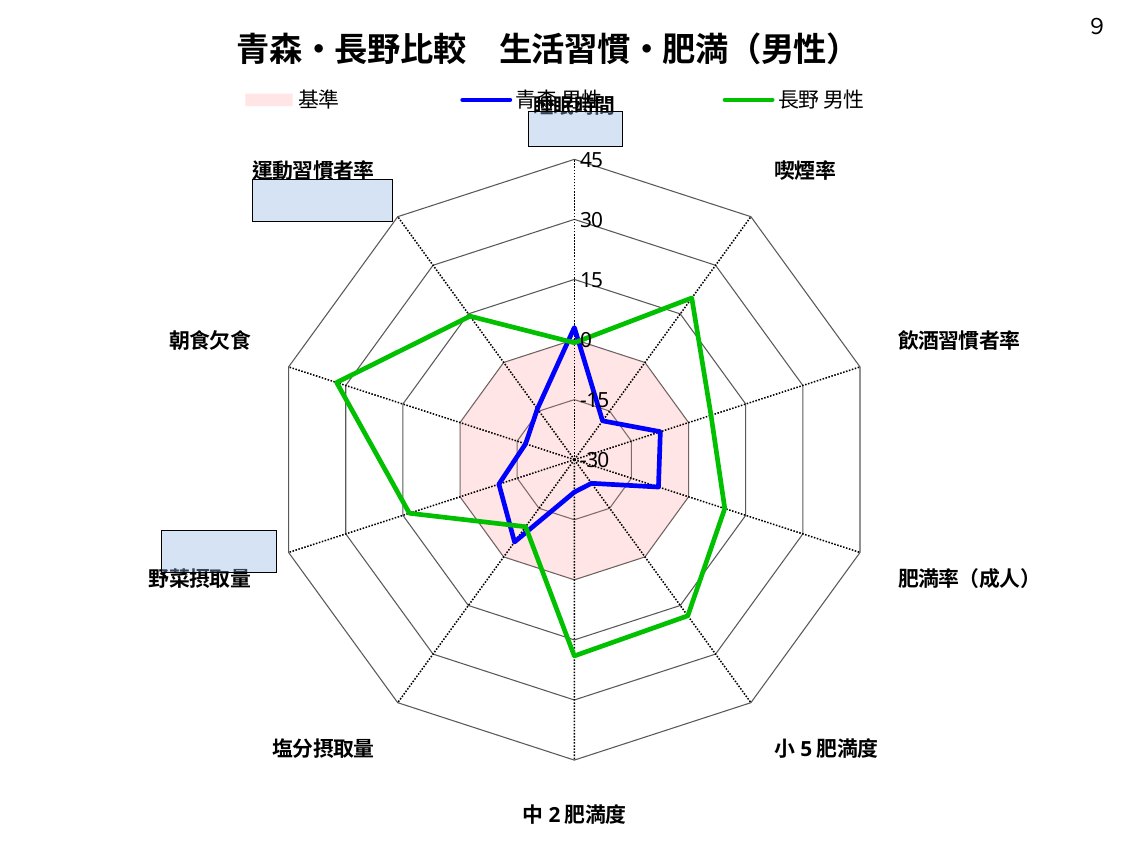
What kind of chart is shown on the slide? radar chart At 朝食欠食, which series has the larger value, 青森 男性 or 長野 男性? 長野 男性 On which axis does 青森 男性 reach its highest value? 睡眠時間 On which axis does 長野 男性 reach its highest value? 朝食欠食 At 飲酒習慣者率, which series has the larger value, 青森 男性 or 長野 男性? 長野 男性 Is the value for 長野 男性 at 中２肥満度 greater or less than 30? less Is the value for 青森 男性 at 飲酒習慣者率 greater or less than 15? less How many axes (categories) does the radar chart have? 10 Which series is drawn with the green line? 長野 男性 How many series does the legend list? 3 Is the value for 青森 男性 at 睡眠時間 greater or less than 15? less What is the title of the chart? 青森・長野比較 生活習慣・肥満（男性）